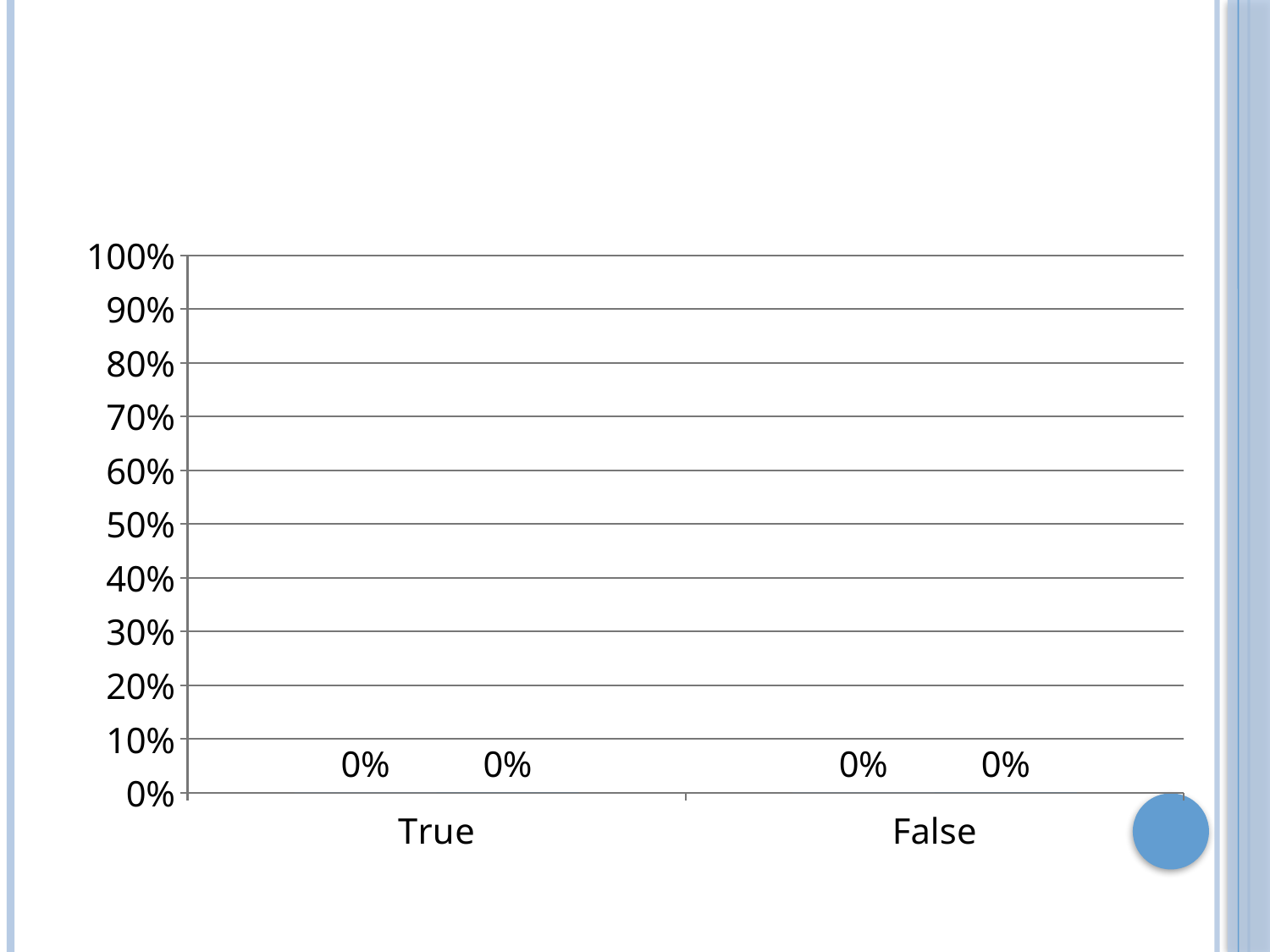
What value is printed as the data label for the second bar in the False category? 0% Is the value for True greater or less than 10%? less Is the value for False greater or less than 50%? less How many categories are shown on the x axis of the chart? 2 What is the difference between the first data label for True and the first data label for False? 0% What kind of chart is shown on the slide? bar chart What is the highest value shown on the y axis of the chart? 100% How many data labels are printed above the False category? 2 What value is printed as the data label for the first bar in the True category? 0% How many data labels are printed on the chart in total? 4 What are the category labels on the x axis of the chart? True and False